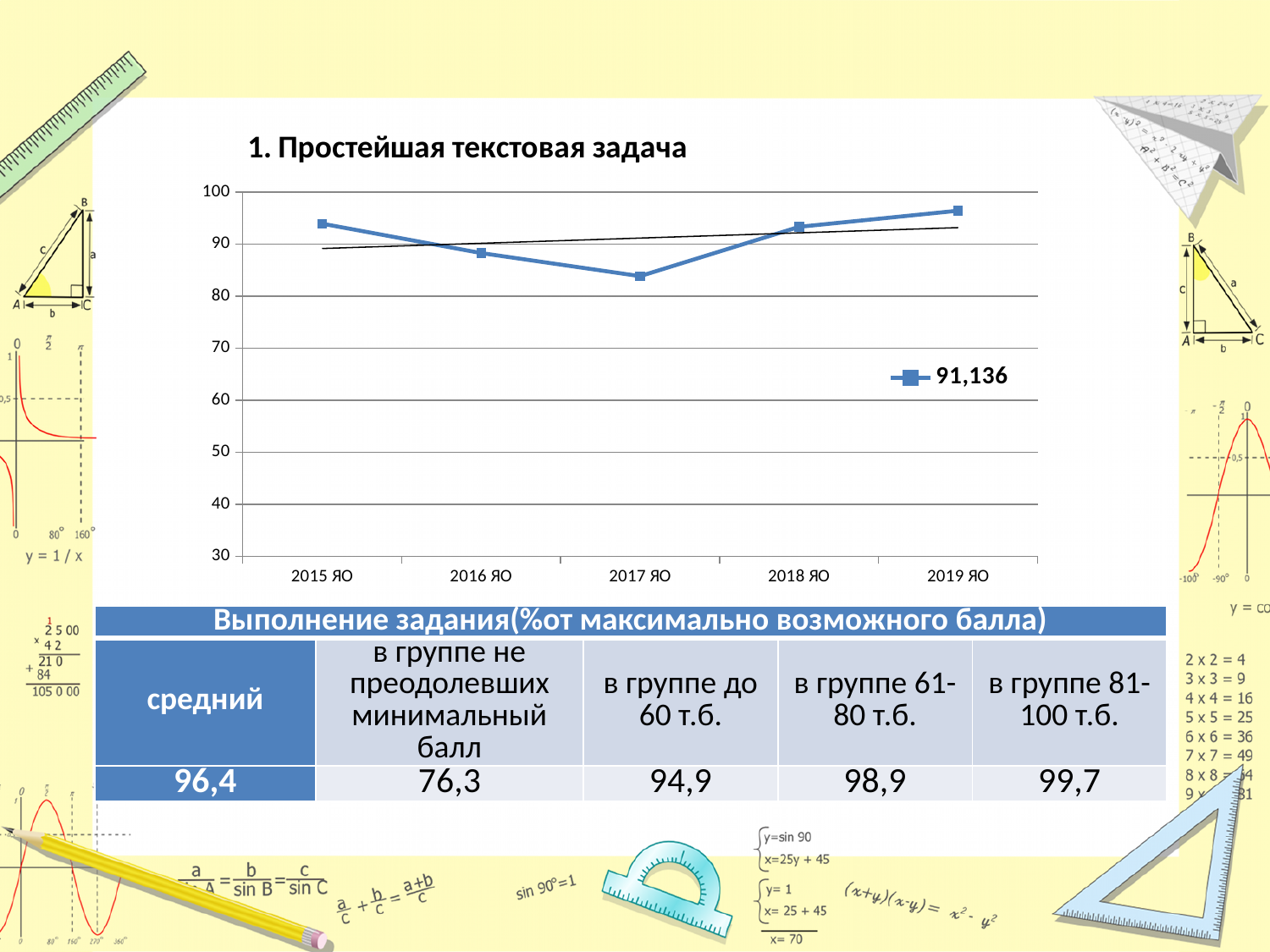
Is the value for 2017 ЯО greater or less than 90? less Which year has the lowest value on the chart? 2017 ЯО Do the values rise or fall from 2015 ЯО to 2017 ЯО? fall Which is larger, the value for 2015 ЯО or the value for 2017 ЯО? 2015 ЯО How many series does the chart legend list? 1 Which year has the highest value on the chart? 2019 ЯО What kind of chart is shown on the slide? line chart Is the value for 2017 ЯО greater or less than 80? greater Do the values rise or fall from 2017 ЯО to 2019 ЯО? rise How many points (years) are plotted along the x axis of the chart? 5 Is the value for 2015 ЯО greater or less than 90? greater What is the title of the chart? 1. Простейшая текстовая задача